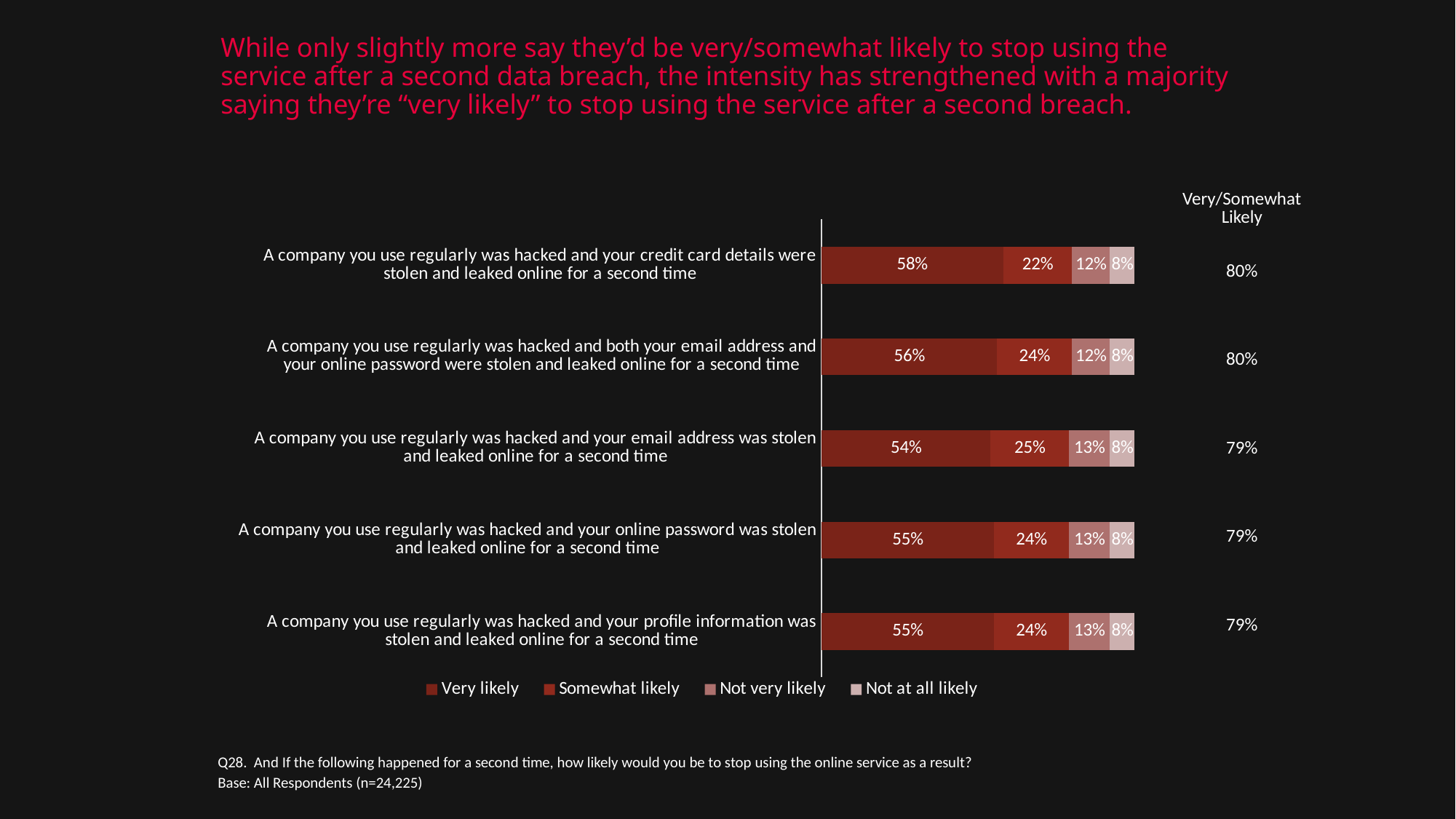
Which scenario has the lowest 'Very likely' value? A company you use regularly was hacked and your email address was stolen and leaked online for a second time What kind of chart is shown on the slide? bar chart What is the 'Not very likely' value for the scenario where the online password was stolen and leaked online for a second time? 13% What is the Very/Somewhat Likely figure shown for the scenario where both the email address and online password were stolen and leaked online for a second time? 80% How many scenarios (categories) are plotted in the chart? 5 How many series does the legend list? 4 Which is larger: the 'Somewhat likely' value for the credit card details scenario or for the email address scenario? the email address scenario What is the 'Somewhat likely' value for the scenario where the email address was stolen and leaked online for a second time? 25% What is the total of the stacked bar for the scenario where profile information was stolen and leaked online for a second time? 100% What is the 'Very likely' value for the scenario where credit card details were stolen and leaked online for a second time? 58% What is the difference in 'Very likely' values between the credit card details scenario and the email address scenario? 4 percentage points Which scenario has the highest 'Very likely' value? A company you use regularly was hacked and your credit card details were stolen and leaked online for a second time